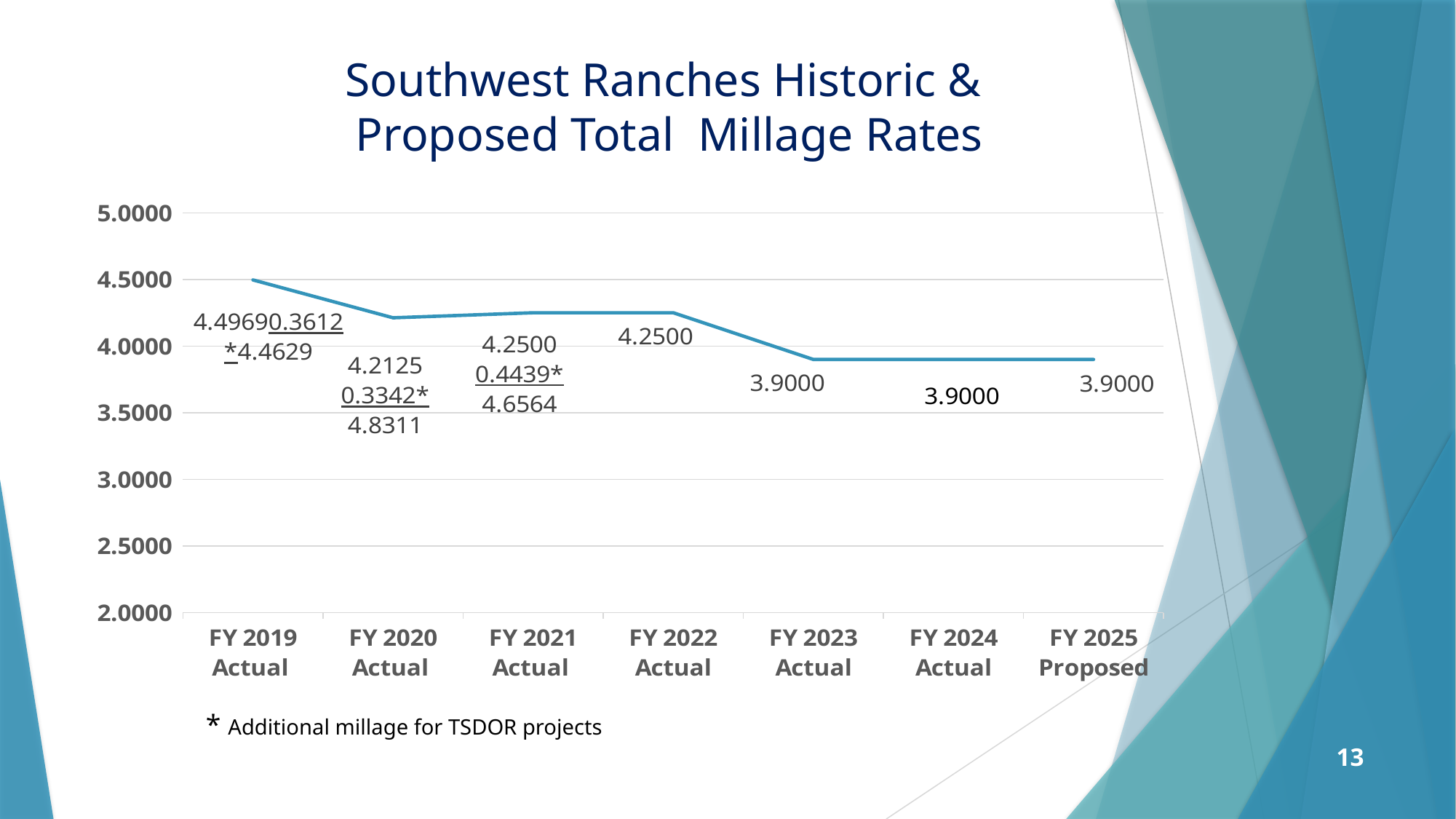
What is the proposed total millage rate for FY 2025? 3.9000 How many fiscal years are shown on the x axis? 7 Is the plotted value for FY 2019 Actual greater or less than 4.0000? greater According to the footnote, what does the asterisk (*) indicate? Additional millage for TSDOR projects What additional millage for TSDOR projects is labelled for FY 2021 Actual? 0.4439 Do the plotted millage rates generally rise or fall from FY 2019 to FY 2025? fall What is the total millage rate plotted for FY 2022 Actual? 4.2500 What is the difference between the FY 2022 Actual rate (4.2500) and the FY 2023 Actual rate (3.9000)? 0.3500 What is the millage rate shown for FY 2023 Actual? 3.9000 What kind of chart is used to show the millage rates? line chart Which is larger, the plotted rate for FY 2022 Actual or FY 2024 Actual? FY 2022 Actual What is the base millage rate labelled for FY 2020 Actual (excluding the additional TSDOR millage)? 4.2125